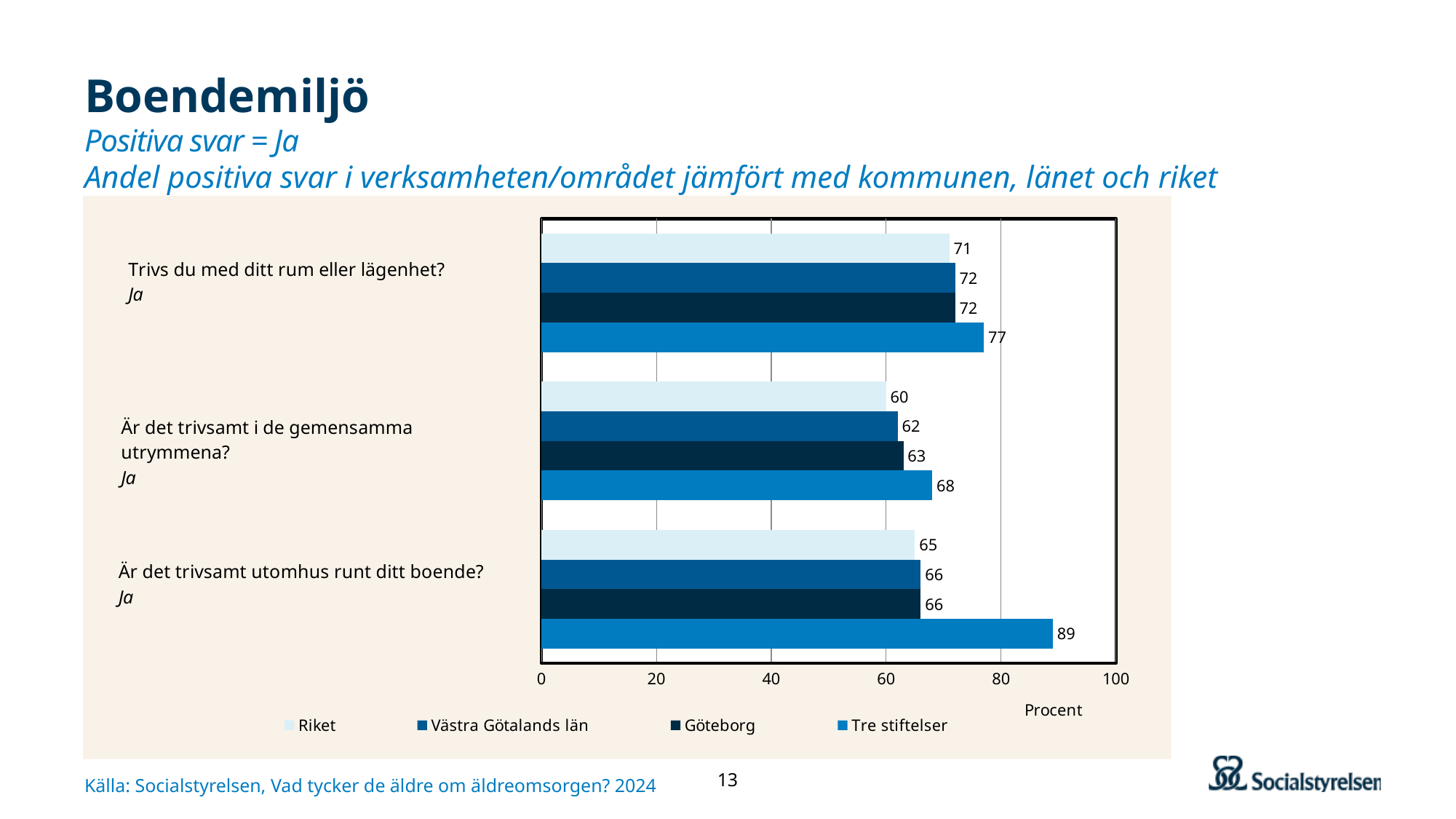
What is the difference between Tre stiftelser and Göteborg for "Trivs du med ditt rum eller lägenhet?"? 5 What is the value for Riket for "Trivs du med ditt rum eller lägenhet?"? 71 Which series has the highest value for "Är det trivsamt i de gemensamma utrymmena?"? Tre stiftelser Which is larger for "Är det trivsamt i de gemensamma utrymmena?": Riket or Västra Götalands län? Västra Götalands län What is the value for Tre stiftelser for "Är det trivsamt utomhus runt ditt boende?"? 89 What is the value for Västra Götalands län for "Är det trivsamt utomhus runt ditt boende?"? 66 How many series does the legend list? 4 What is the value for Göteborg for "Är det trivsamt i de gemensamma utrymmena?"? 63 What is the difference between Tre stiftelser and Riket for "Är det trivsamt utomhus runt ditt boende?"? 24 What kind of chart is shown on the slide? Bar chart How many questions (categories) are shown on the chart? 3 Which series has the lowest value for "Är det trivsamt utomhus runt ditt boende?"? Riket